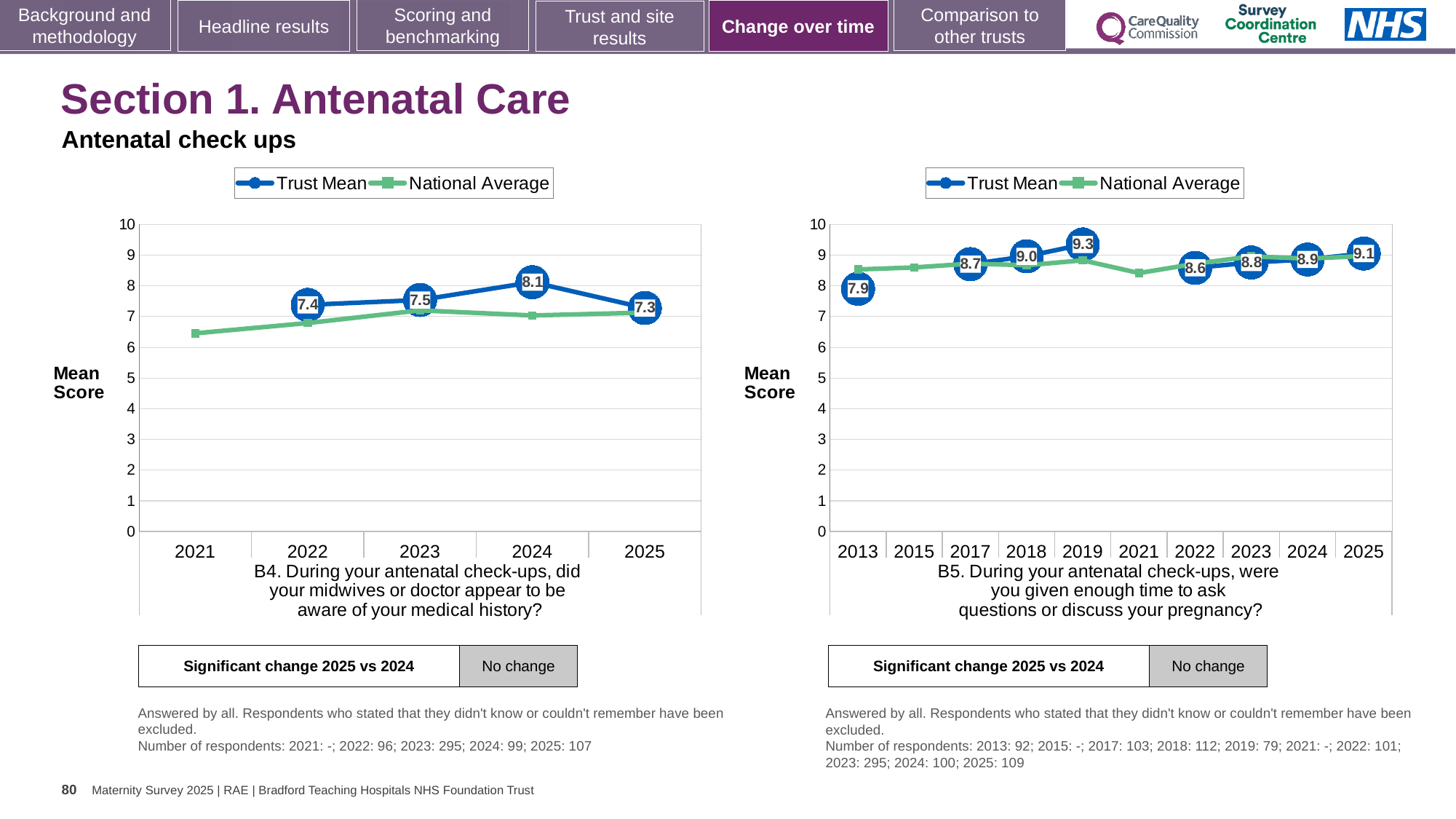
In the B4 chart on the left, what is the Trust Mean for 2024? 8.1 In the B4 chart on the left, what is the Trust Mean for 2025? 7.3 In the B4 chart on the left, which year has the highest Trust Mean? 2024 In the B5 chart on the right, how many years are shown on the x axis? 10 In the B4 chart on the left, what is the difference between the Trust Mean for 2024 and 2025? 0.8 In the B5 chart on the right, what is the difference between the Trust Mean for 2019 and 2013? 1.4 In the B5 chart on the right, is the Trust Mean higher in 2018 or in 2022? 2018 In the B4 chart on the left, how many series does the legend list? 2 In the B5 chart on the right, what is the Trust Mean for 2019? 9.3 In the B5 chart on the right, which year has the lowest Trust Mean? 2013 In the B4 chart on the left, is the National Average for 2021 greater or less than 7? less What type of chart is the B5 chart on the right? Line chart